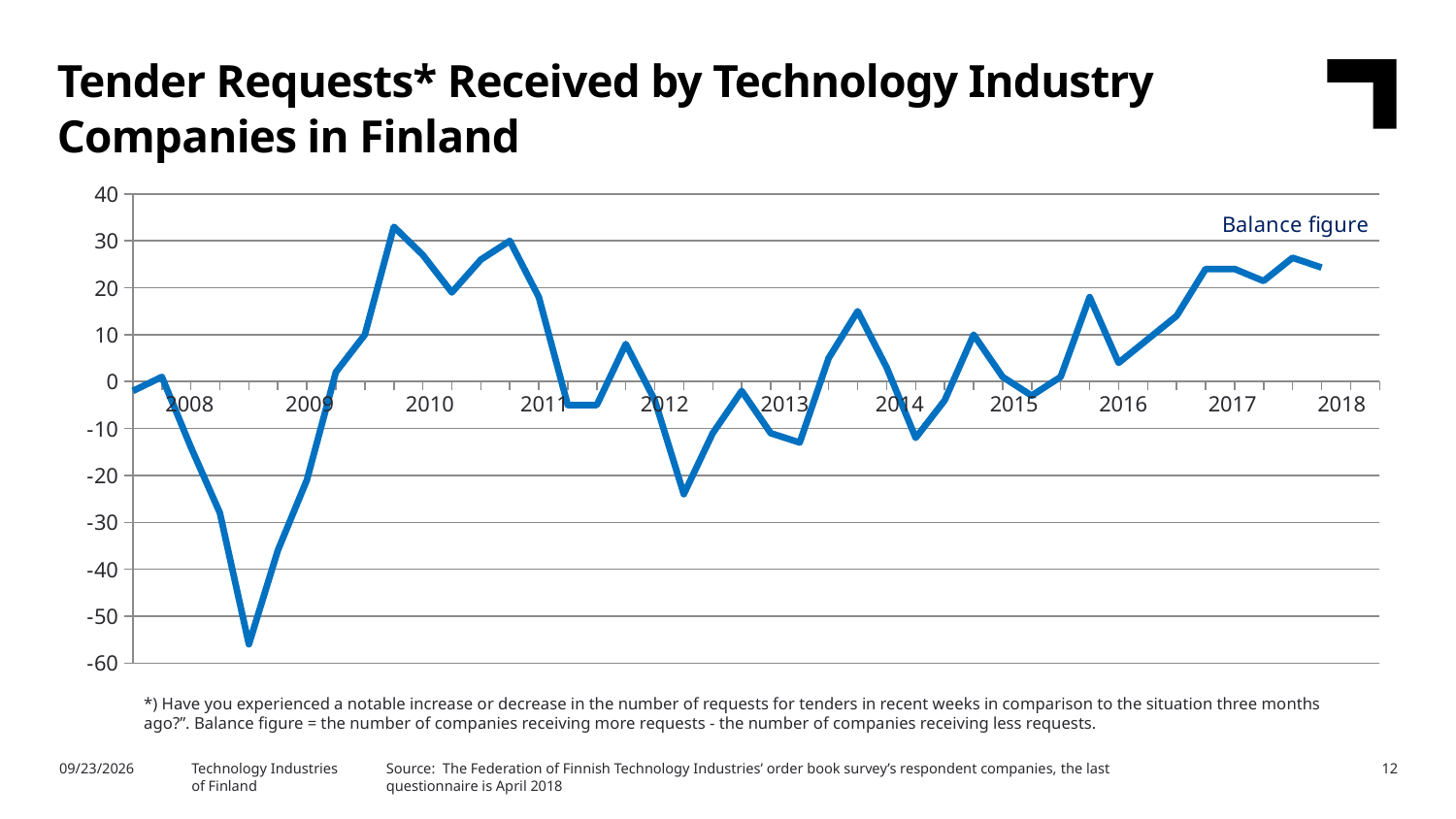
Is the lowest balance figure in 2013 greater or less than -10? less What kind of chart is shown on the slide? line chart Does the balance figure rise or fall between its low point in early 2009 and its peak in 2010? rise Which is higher: the peak of the balance figure around 2010 or the peak around 2017? 2010 Is the lowest balance figure in 2012 greater or less than -20? less Is the lowest value of the balance figure, reached around the start of 2009, greater or less than -50? less What is the title of the chart on the slide? Tender Requests* Received by Technology Industry Companies in Finland How many year labels are shown on the x axis? 11